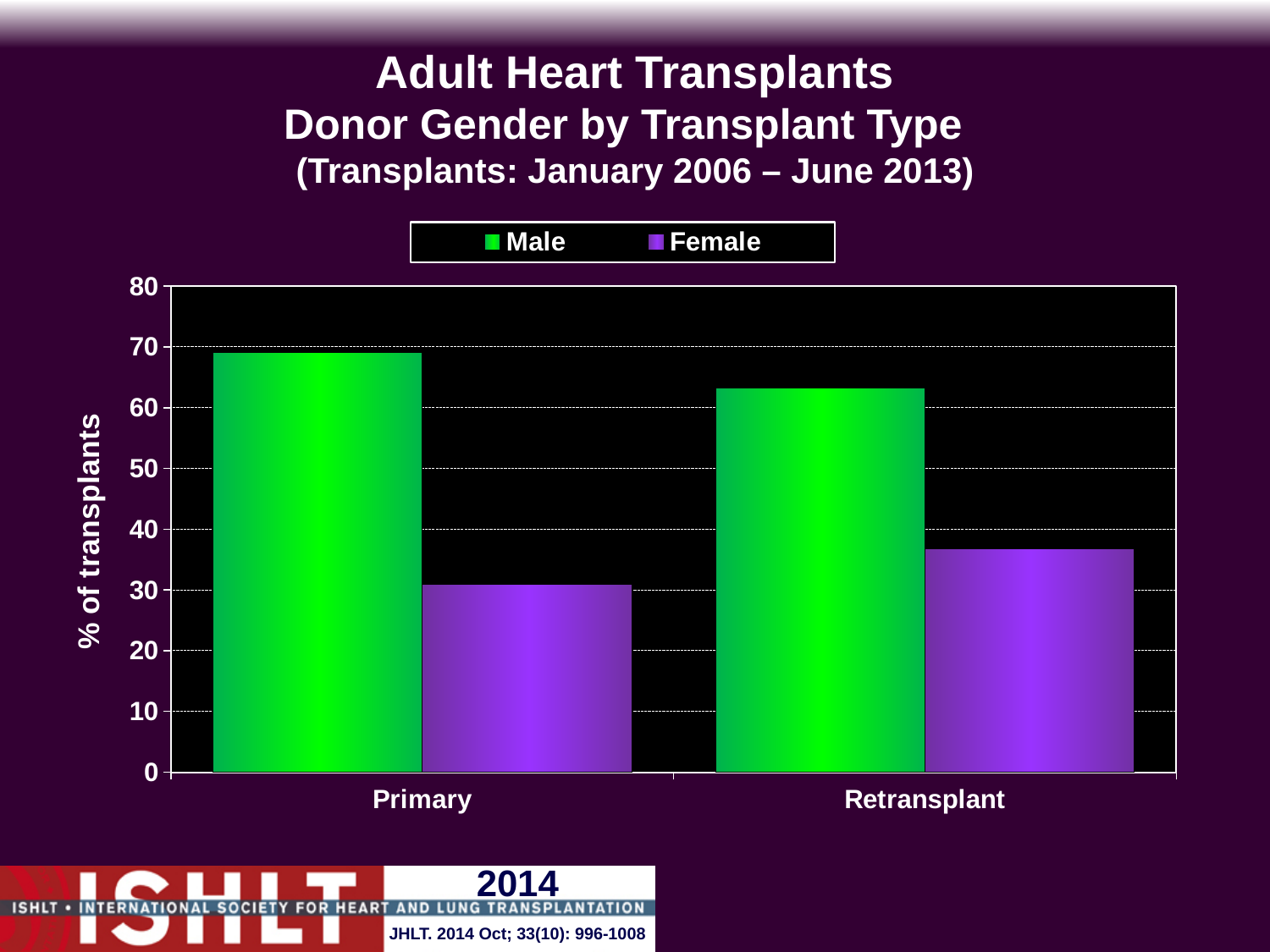
Is the value for Male donors in Retransplant greater or less than 70? less Is the value for Female donors in Primary transplants greater or less than 40? less Is the value for Female donors in Retransplant greater or less than 30? greater How many series does the legend list? 2 For Retransplant, which donor gender has the larger share of transplants? Male What is the label of the y axis? % of transplants Which is larger: the Female share for Primary transplants or the Female share for Retransplant? Retransplant Which bar is the tallest in the chart? Male, Primary How many transplant type categories are shown on the x axis? 2 Which bar is the shortest in the chart? Female, Primary What kind of chart is shown on the slide? bar chart